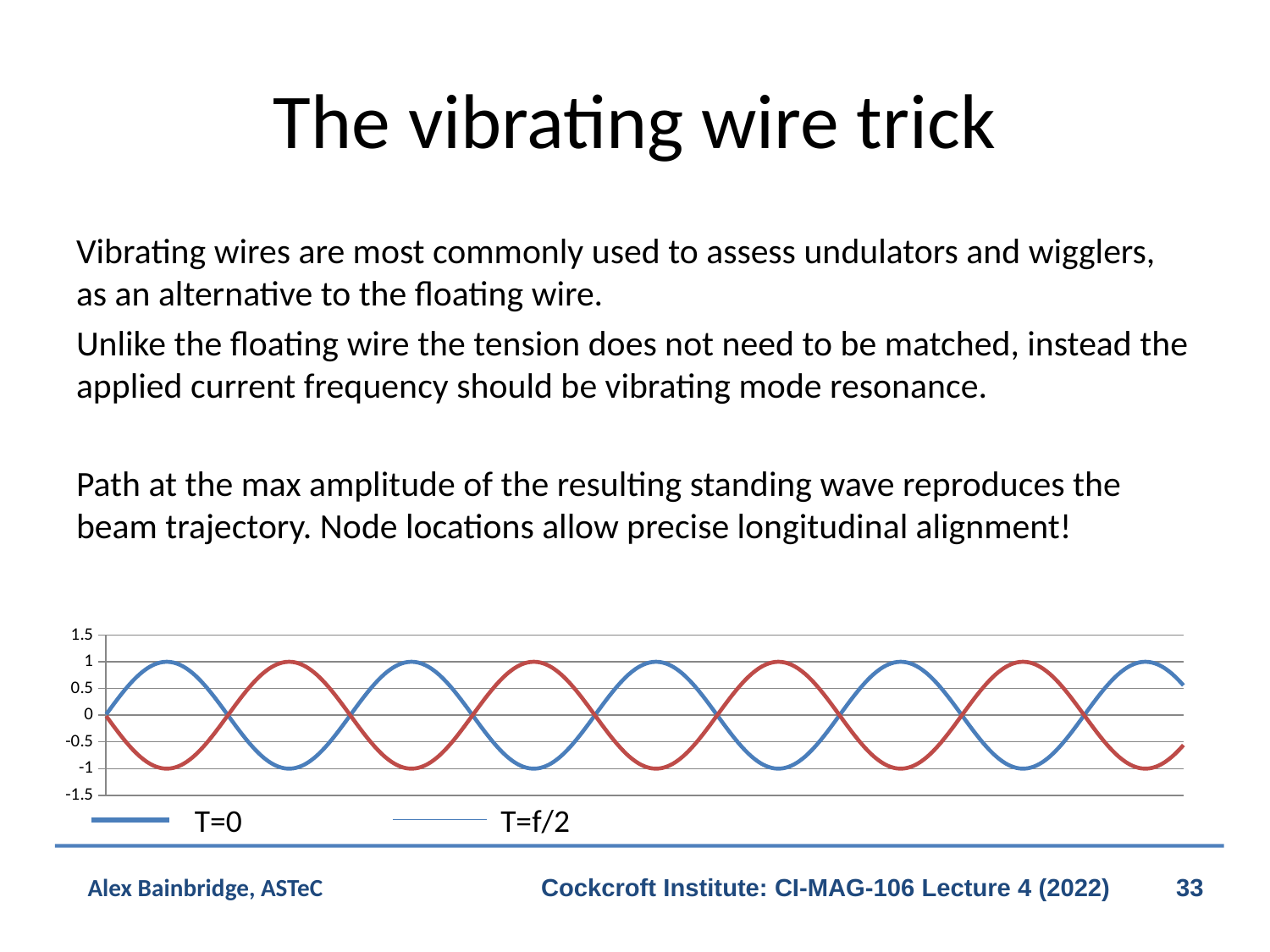
Is the first peak of the blue line greater or less than 0.5? greater Is the first trough of the red line greater or less than -0.5? less What is the minimum value reached by the red line in the chart? -1 How many peaks (maxima) does the red line have in the chart? 4 How many series does the chart legend list? 2 What kind of chart is shown at the bottom of the slide? line chart What is the maximum value reached by the blue line in the chart? 1 How many peaks (maxima) does the blue line have in the chart? 5 What is the highest tick value shown on the chart's vertical axis? 1.5 At the left edge of the chart, do the blue and red lines start at the same value? yes, both start at 0 What are the two series names shown in the chart legend? T=0 and T=f/2 What is the lowest tick value shown on the chart's vertical axis? -1.5